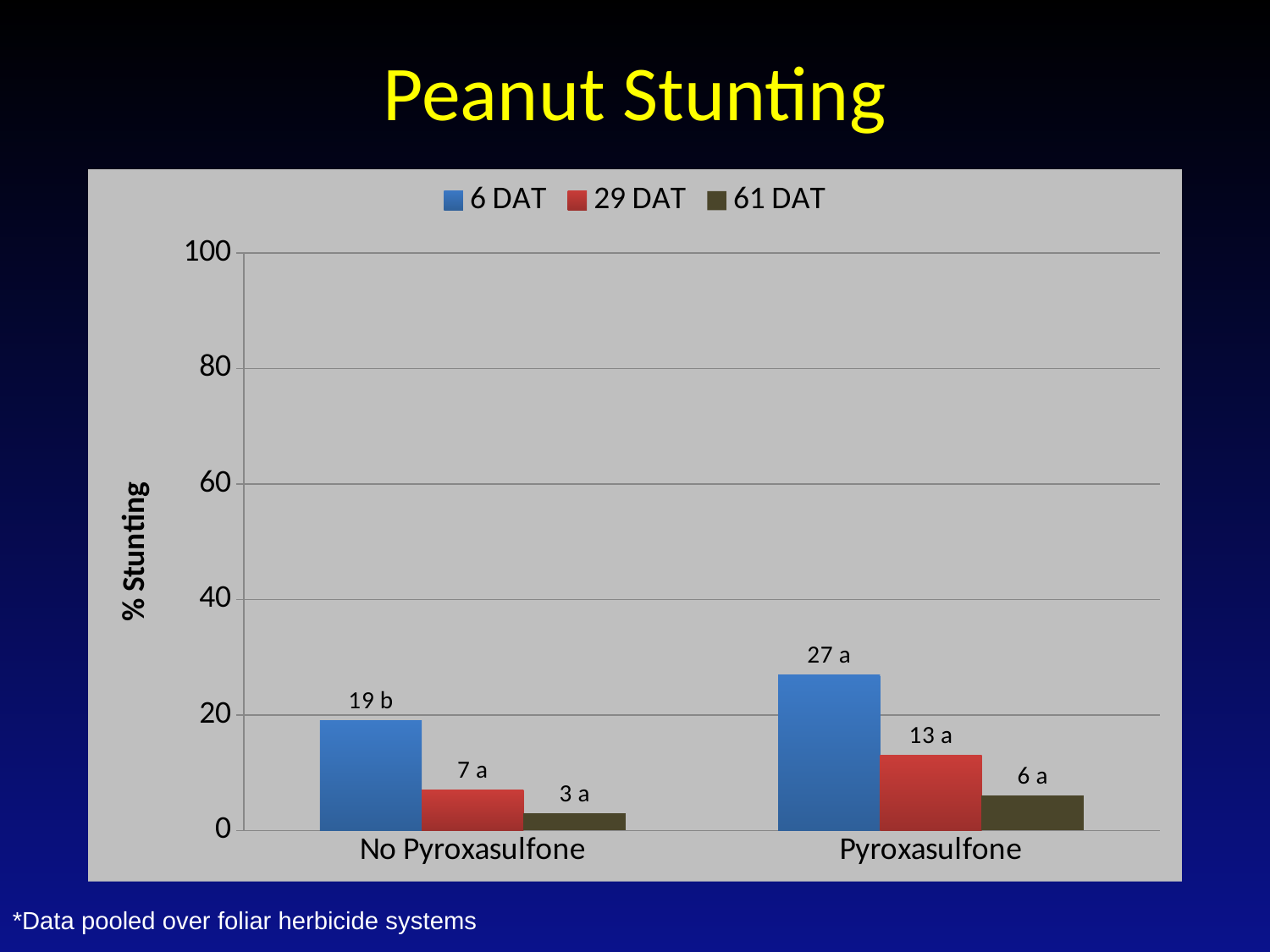
Which is larger: the 29 DAT value for Pyroxasulfone or the 29 DAT value for No Pyroxasulfone? Pyroxasulfone Which series has the highest value in the Pyroxasulfone category? 6 DAT How many series does the legend list? 3 Is the 6 DAT value for Pyroxasulfone greater or less than 20? greater How many categories are shown on the x axis? 2 What is the value for 29 DAT in the Pyroxasulfone category? 13 a What is the difference between the 6 DAT values for Pyroxasulfone and No Pyroxasulfone? 8 What is the label of the y axis? % Stunting What is the value for 6 DAT in the No Pyroxasulfone category? 19 b Which series has the lowest value in the No Pyroxasulfone category? 61 DAT What kind of chart is shown on the slide? bar chart What is the value for 61 DAT in the No Pyroxasulfone category? 3 a